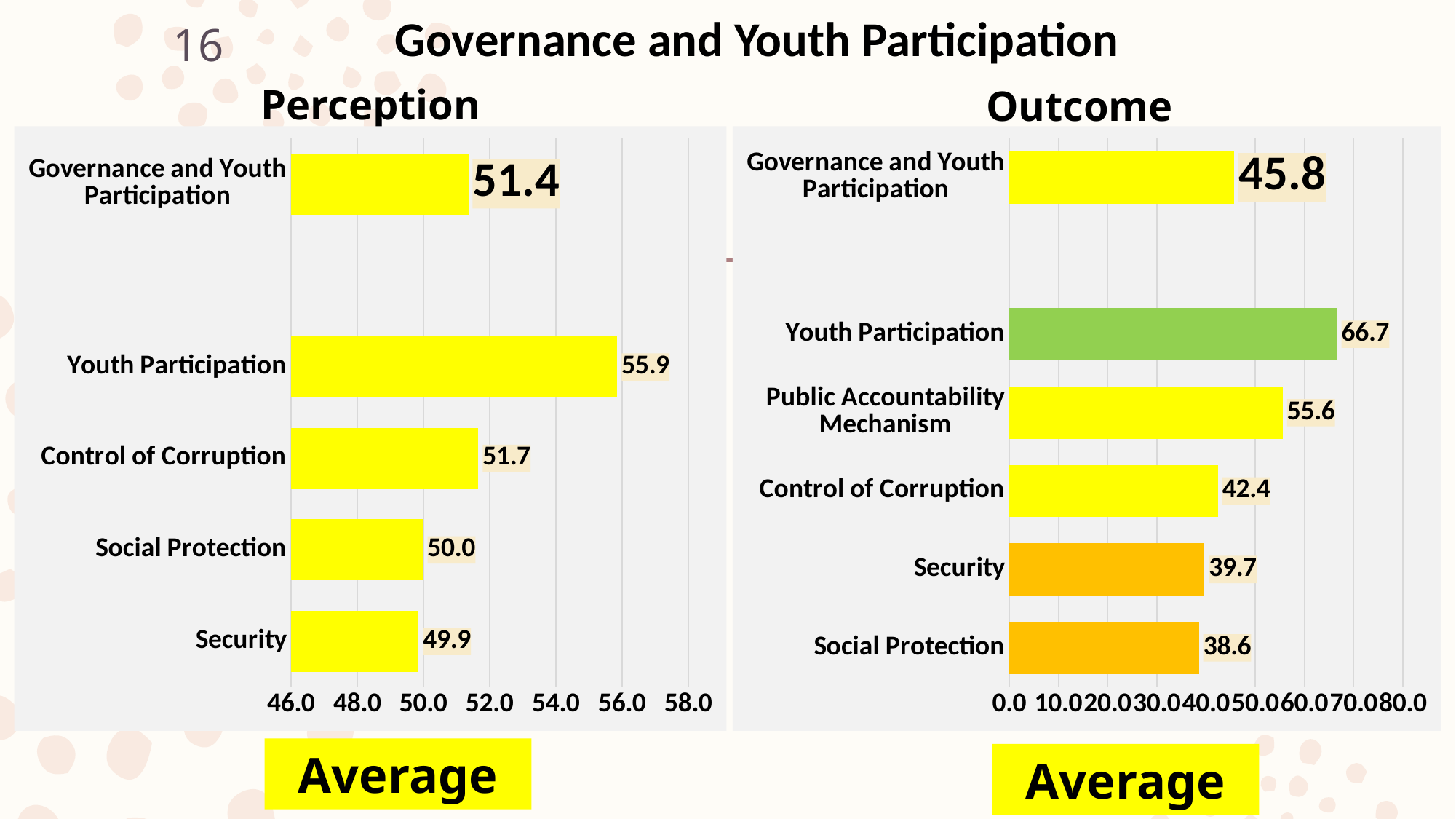
In the Outcome chart, what is the value for Public Accountability Mechanism? 55.6 What type of chart is the Perception chart? Bar chart In the Outcome chart, what is the value for Social Protection? 38.6 In the Outcome chart, how many bars are plotted? 6 In the Perception chart, what is the value for Governance and Youth Participation? 51.4 In the Perception chart, which category has the lowest value? Security In the Outcome chart, which is larger, Control of Corruption or Security? Control of Corruption In the Perception chart, what is the difference between Control of Corruption and Social Protection? 1.7 In the Outcome chart, which category has the highest value? Youth Participation In the Outcome chart, what is the difference between Youth Participation and Security? 27.0 In the Perception chart, what is the value for Youth Participation? 55.9 In the Outcome chart, what colour is the Youth Participation bar? Green